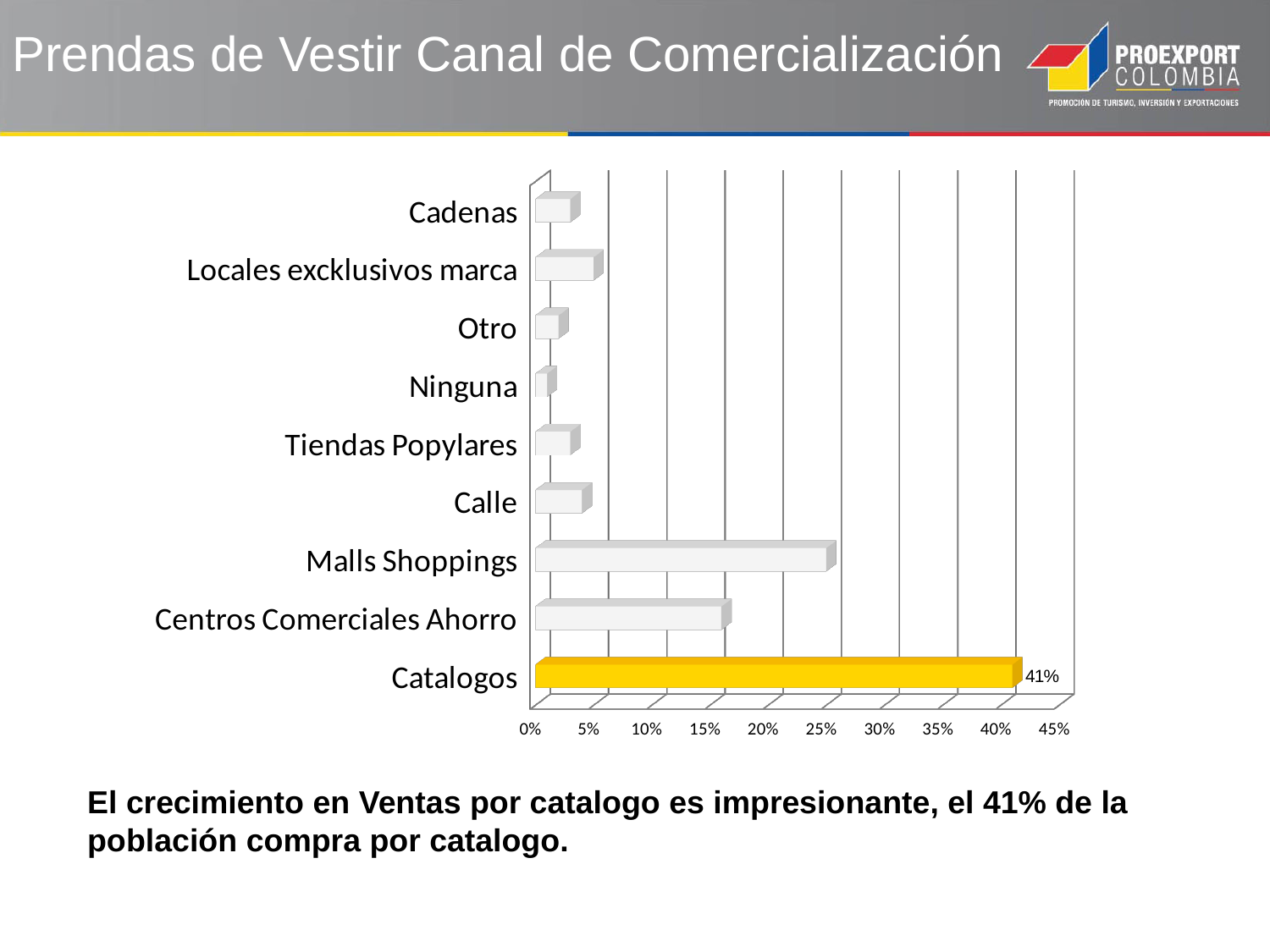
Which category has the highest value? Catalogos Is the value for Malls Shoppings greater or less than 30%? less Which category's bar is highlighted in yellow? Catalogos What kind of chart is shown on the slide? Bar chart How many categories are shown in the chart? 9 Is the value for Centros Comerciales Ahorro greater or less than 20%? less Which is larger, Malls Shoppings or Centros Comerciales Ahorro? Malls Shoppings Which is larger, Catalogos or Malls Shoppings? Catalogos Is the value for Malls Shoppings greater or less than 20%? greater Which category has the lowest value? Ninguna What is the value for Catalogos? 41%